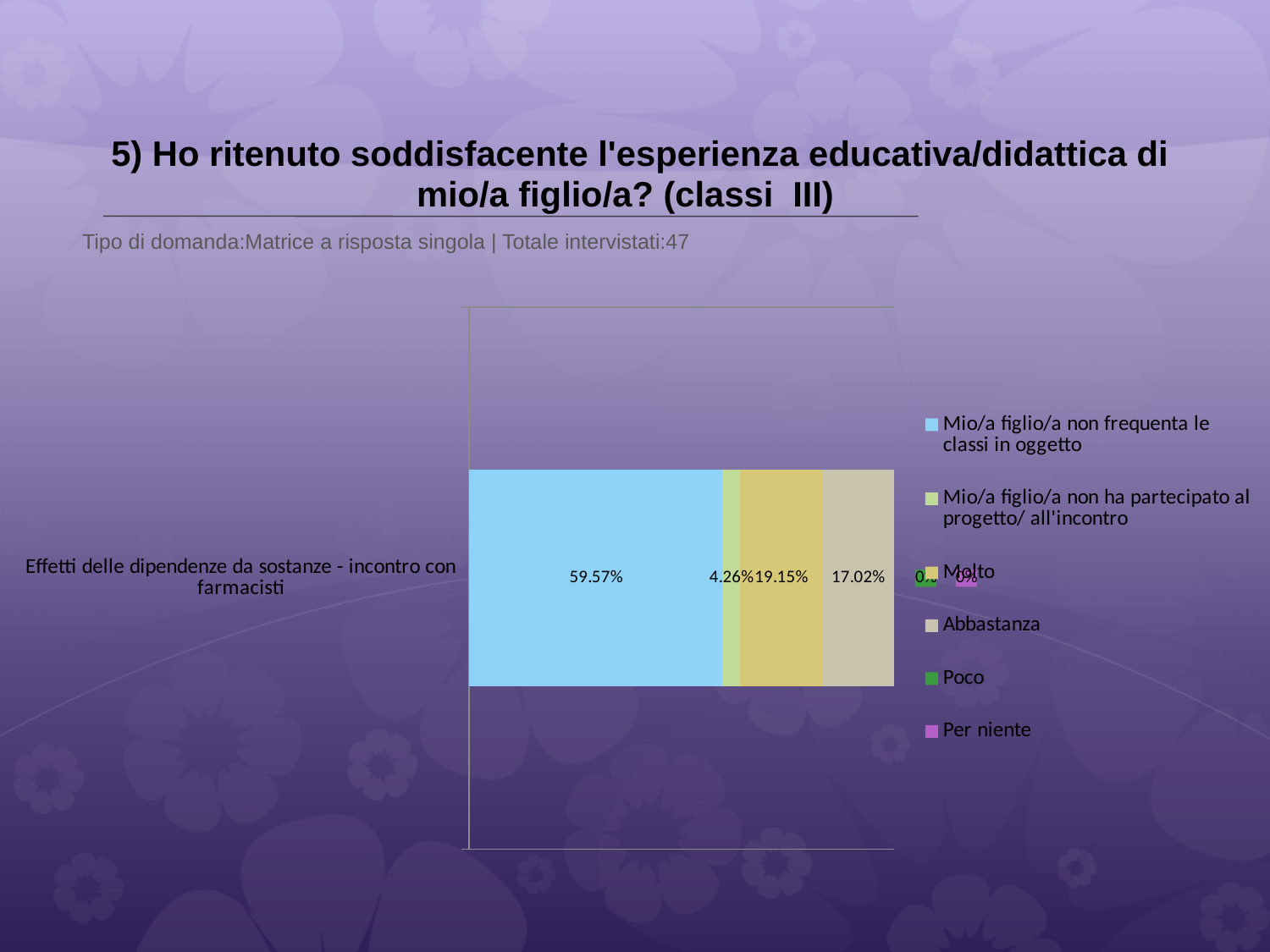
What is the value for 'Abbastanza'? 17.02% What is the value for 'Mio/a figlio/a non ha partecipato al progetto/ all'incontro'? 4.26% How many categories are plotted on the chart? 1 What is the difference between the values for 'Molto' and 'Abbastanza'? 2.13% What is the total number of respondents stated on the slide? 47 Which is larger, the value for 'Molto' or the value for 'Abbastanza'? Molto What is the value for 'Molto'? 19.15% What kind of chart is shown on the slide? Stacked bar chart How many series does the legend list? 6 What is the value for 'Poco'? 0% What is the value for 'Mio/a figlio/a non frequenta le classi in oggetto'? 59.57% Which series has the highest value? Mio/a figlio/a non frequenta le classi in oggetto